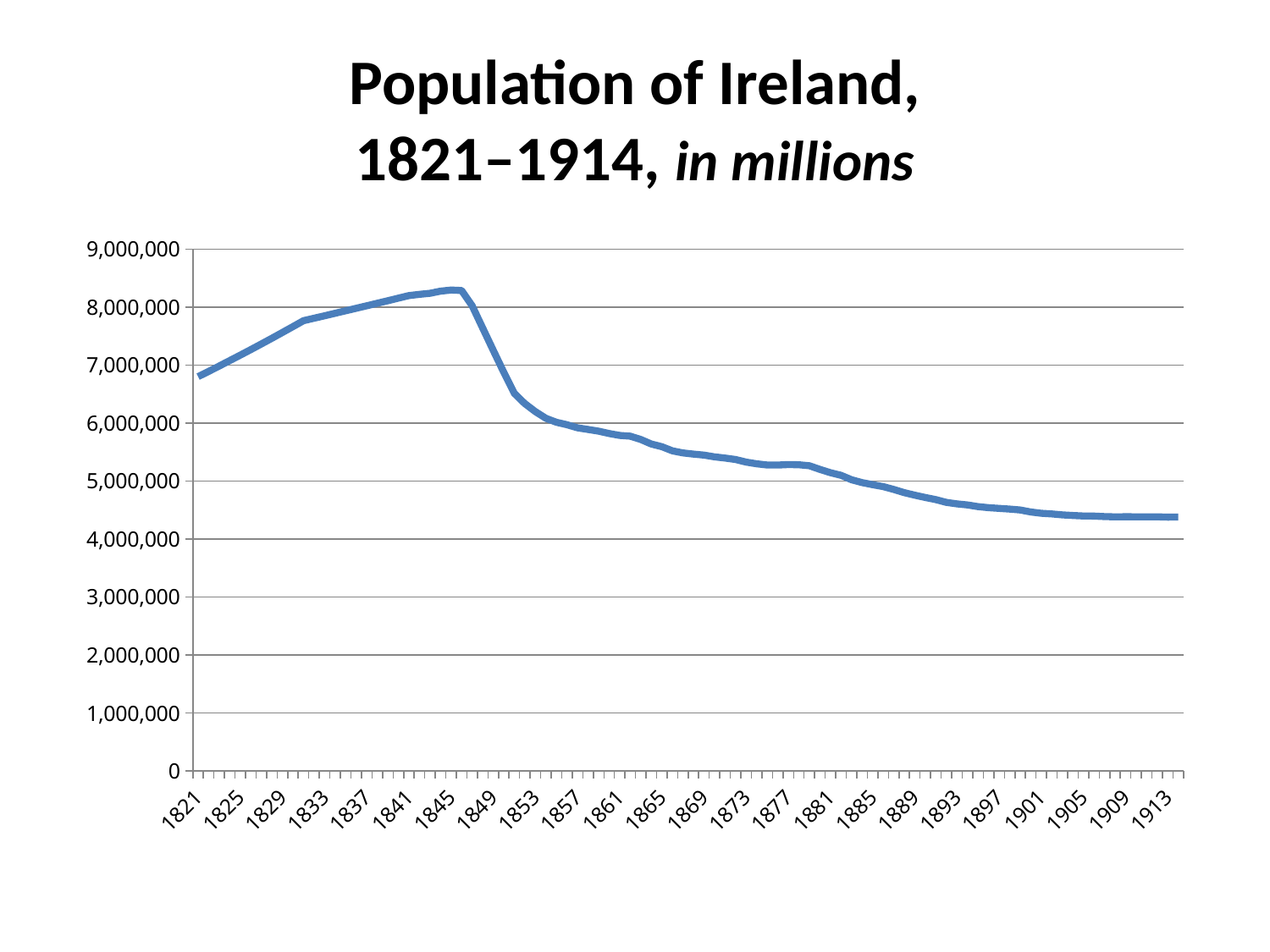
Is the population value for 1913 greater or less than 5,000,000? less Is the population value for 1861 greater or less than 6,000,000? less Is the population value for 1821 greater or less than 7,000,000? less What is the title of the chart? Population of Ireland, 1821–1914, in millions Does the population rise or fall between 1821 and 1845? rise Which year has the larger population, 1845 or 1853? 1845 Which year has the larger population, 1821 or 1913? 1821 What kind of chart is shown on the slide? line chart Does the population rise or fall between 1849 and 1913? fall